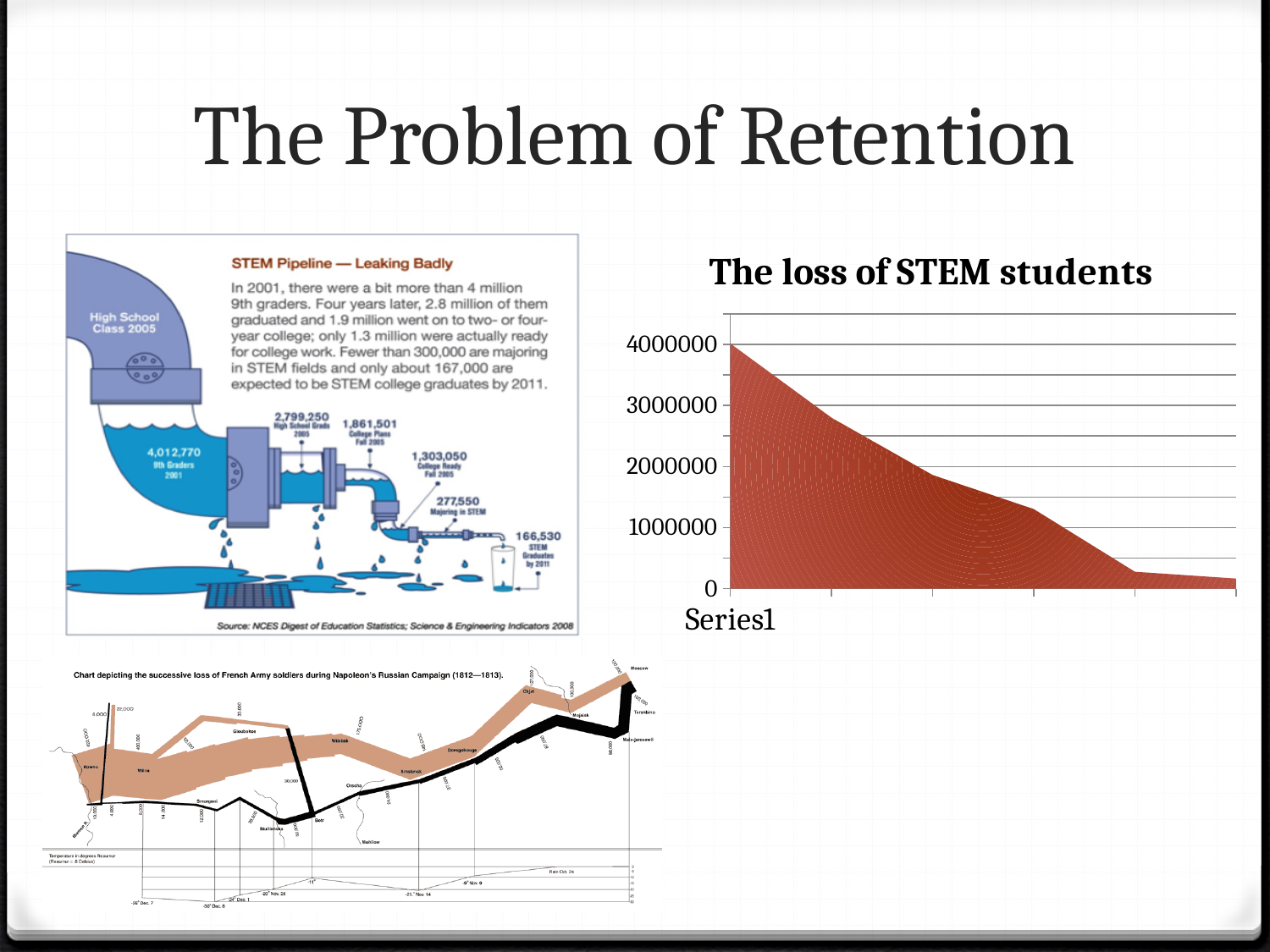
In 'The loss of STEM students' chart, do the values rise or fall from left to right along the x axis? fall In 'The loss of STEM students' chart, is the value at the second point from the right greater or less than 1000000? less In 'The loss of STEM students' chart, is the value at the rightmost point greater or less than 1000000? less In 'The loss of STEM students' chart, is the value at the leftmost point greater or less than 3000000? greater What kind of chart is 'The loss of STEM students'? area chart In 'The loss of STEM students' chart, which point has the highest value, the leftmost or the rightmost? leftmost What is the highest value shown on the y axis of 'The loss of STEM students' chart? 4000000 What is the title of the area chart on the right of the slide? The loss of STEM students How many data points are plotted in 'The loss of STEM students' chart? 6